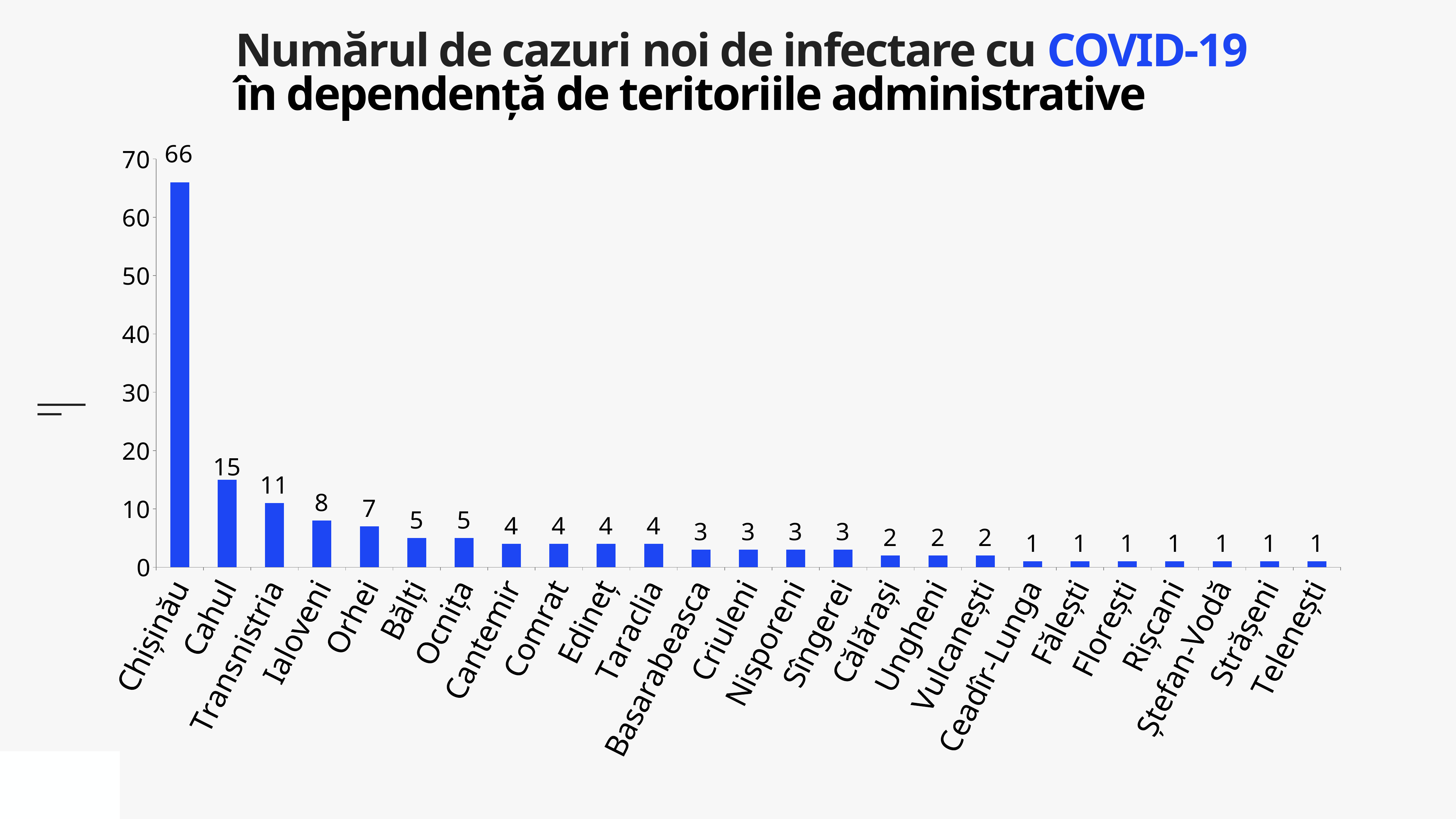
Which is larger, the value for Transnistria or the value for Ialoveni? Transnistria What is the difference between the values for Chișinău and Cahul? 51 What is the value for Ungheni? 2 How many categories are shown on the x axis? 25 What is the difference between the values for Ialoveni and Bălți? 3 What kind of chart is shown on the slide? bar chart What is the value for Transnistria? 11 What is the value for Orhei? 7 What is the value for Cahul? 15 What is the value for Chișinău? 66 Which category has the highest value? Chișinău Is the value for Chișinău greater or less than 60? greater